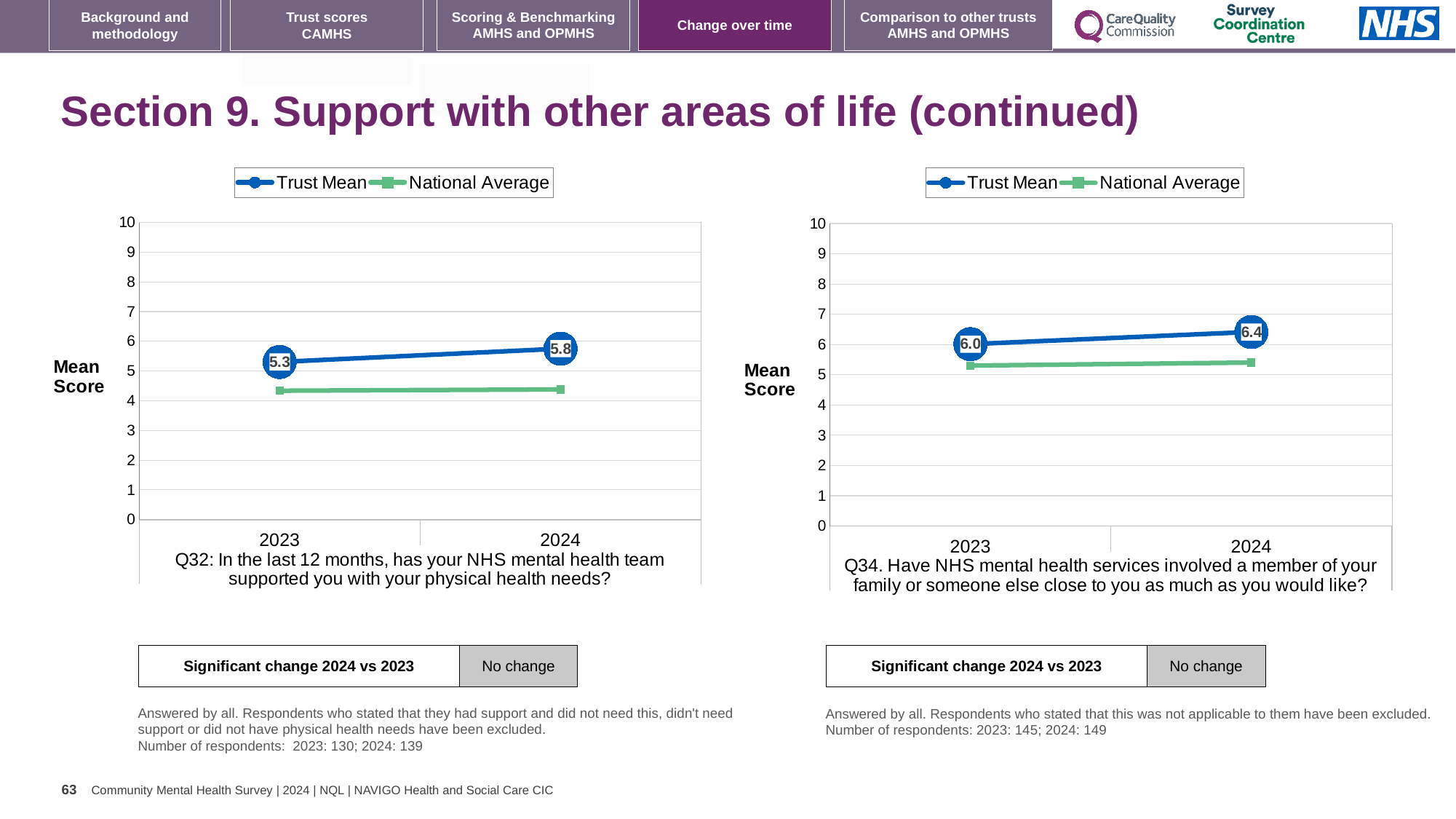
In the right chart (Q34), what is the difference between the Trust Mean in 2024 and in 2023? 0.4 What kind of chart is the left chart (Q32)? line chart In the right chart (Q34), which series is higher in 2024, Trust Mean or National Average? Trust Mean In the left chart (Q32), is the National Average for 2024 greater or less than 5? less How many years are shown on the x axis of the left chart (Q32)? 2 How many series does the legend of the right chart (Q34) list? 2 In the right chart (Q34), what is the Trust Mean for 2023? 6.0 In the left chart (Q32), what is the Trust Mean for 2023? 5.3 In the right chart (Q34), does the Trust Mean rise or fall from 2023 to 2024? rise In the left chart (Q32), what is the Trust Mean for 2024? 5.8 In the right chart (Q34), what is the Trust Mean for 2024? 6.4 In the left chart (Q32), by how much did the Trust Mean change from 2023 to 2024? 0.5